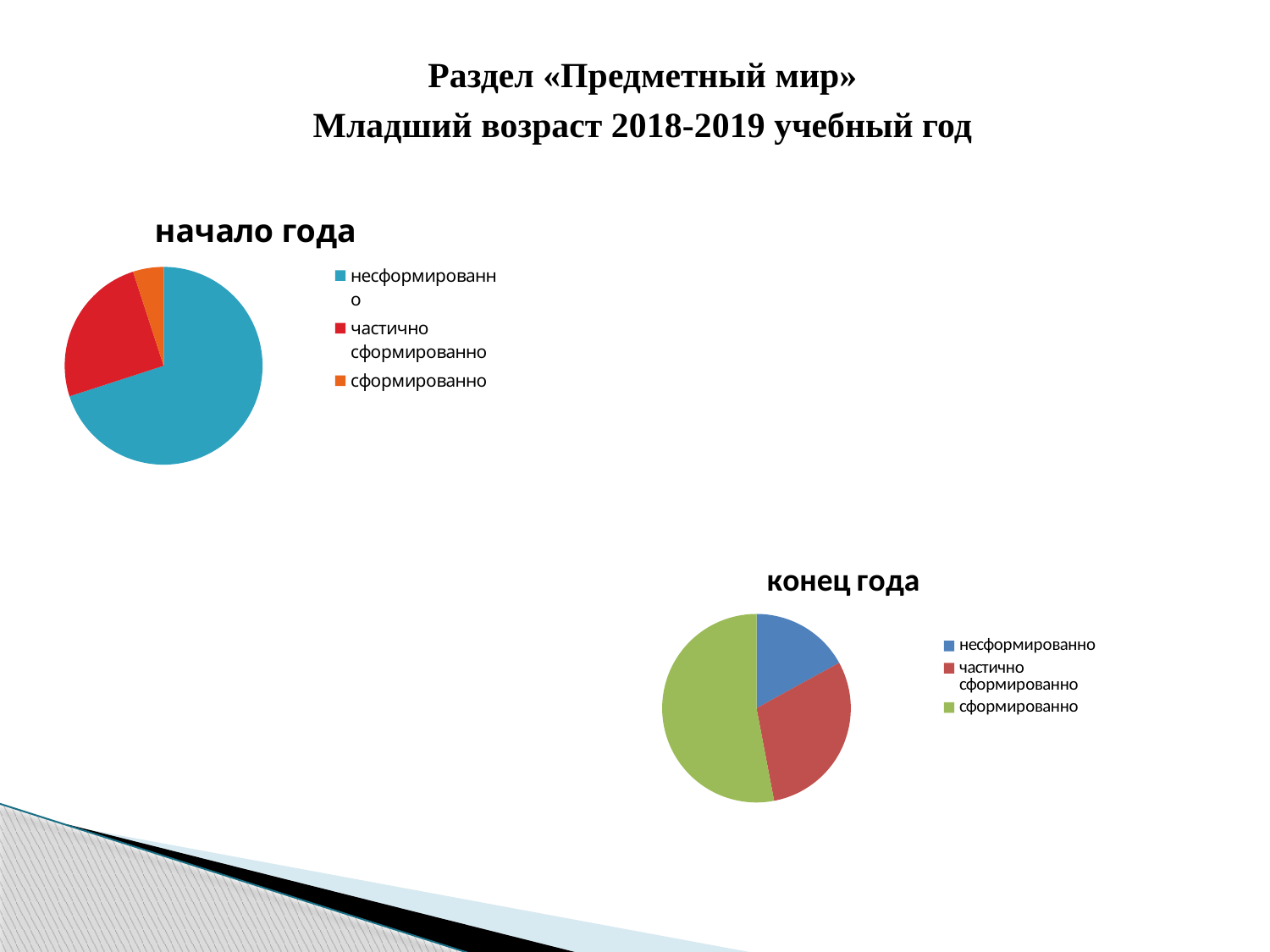
What kind of chart is the "конец года" chart? pie chart In the "начало года" chart, which category has the smallest slice? сформированно How many slices does the "конец года" pie chart have? 3 In the "конец года" chart, which slice is larger: "сформированно" or "несформированно"? сформированно In the "начало года" chart, which category has the largest slice? несформированно In the "начало года" chart, which slice is larger: "частично сформированно" or "сформированно"? частично сформированно How many slices does the "начало года" pie chart have? 3 In the "конец года" chart, which category has the largest slice? сформированно What kind of chart is the "начало года" chart? pie chart In the "конец года" chart, which category has the smallest slice? несформированно How many entries does the legend of the "конец года" chart list? 3 What colour is the "сформированно" slice in the "конец года" chart? green